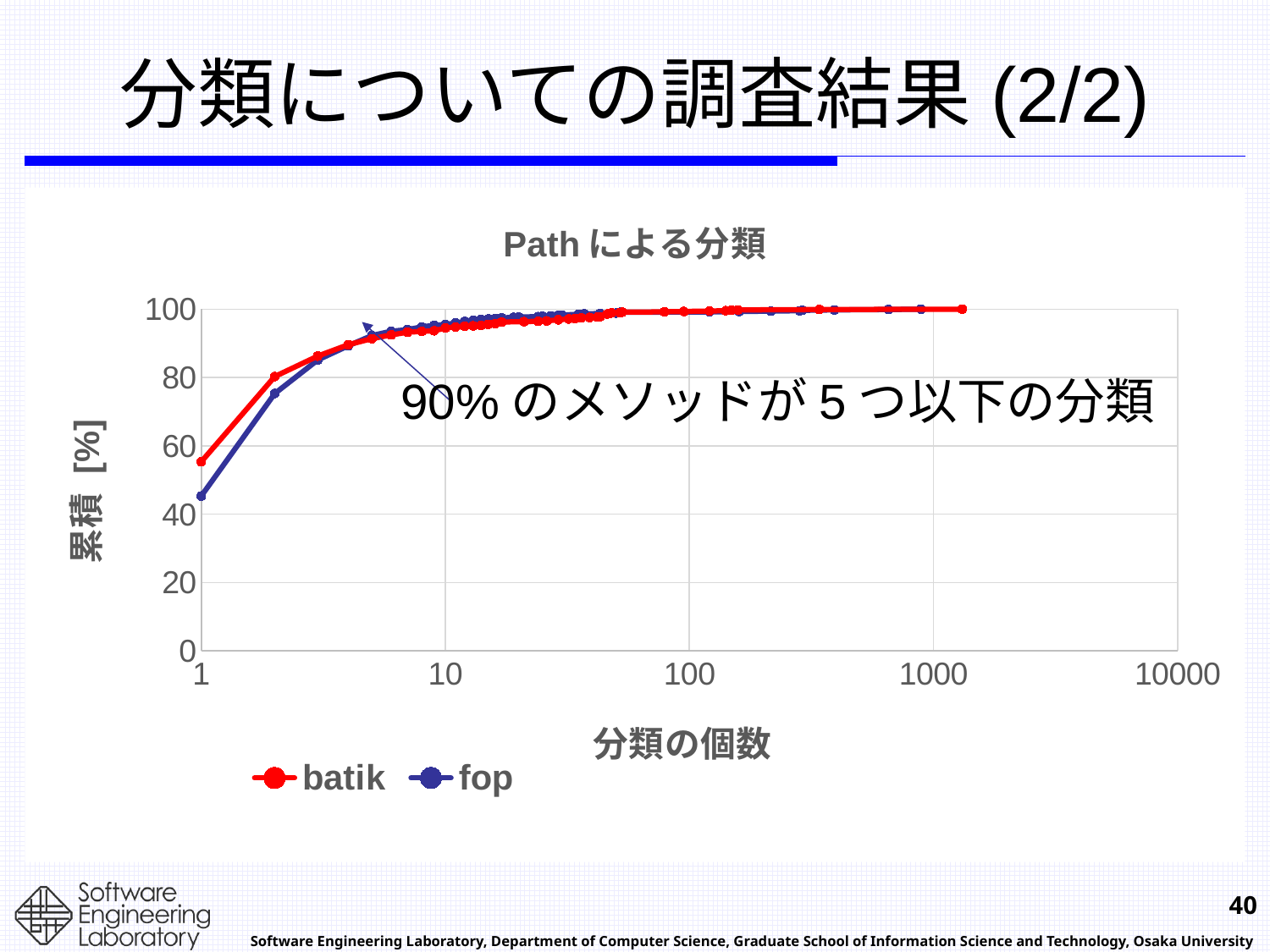
Do the values of the batik series rise or fall as the number of categories increases along the x axis? rise Is the value for batik at x = 100 greater or less than 80? greater Is the value for fop at x = 1 greater or less than 60? less What kind of chart is shown on the slide? line chart Is the value for batik at x = 1 greater or less than 40? greater What are the names of the two series in the legend? batik and fop At x = 1, which series has the larger value, batik or fop? batik How many series does the legend list? 2 What is the title of the chart? Path による分類